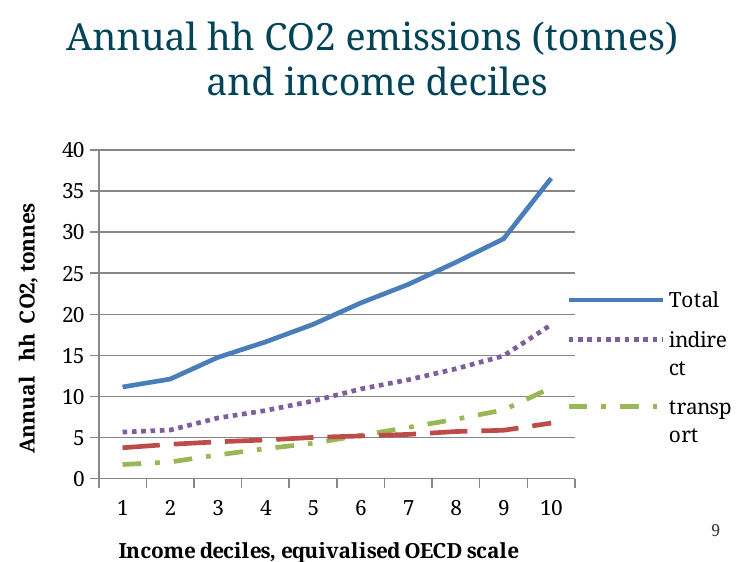
Is the Total value at income decile 1 greater or less than 10? greater What kind of chart is shown on the slide? line chart At which income decile is the Total series lowest? 1 Is the indirect value at income decile 10 greater or less than 15? greater Does the Total series rise or fall as income decile increases from 1 to 10? rise At which income decile is the Total series highest? 10 Is the transport value at income decile 1 greater or less than 5? less How many income deciles are plotted along the x axis? 10 What is the label of the x axis? Income deciles, equivalised OECD scale How many series does the legend list? 3 At income decile 10, which is larger: Total or indirect? Total